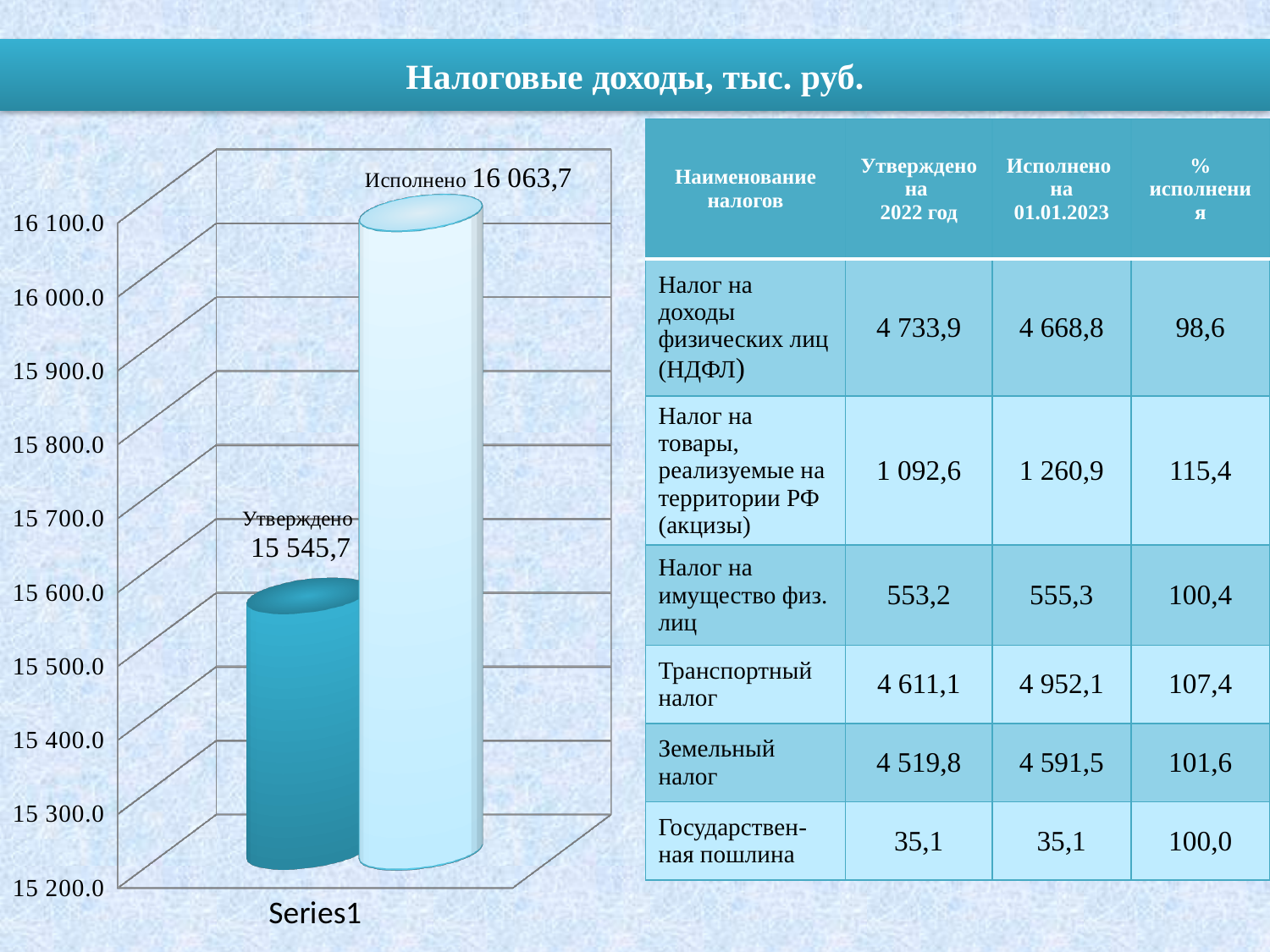
What is the value of the Исполнено bar? 16 063,7 What is the difference between the Исполнено and Утверждено values? 518,0 Is the Утверждено value larger or smaller than the Исполнено value? smaller What is the value of the Утверждено bar? 15 545,7 Is the value for Утверждено greater or less than 15 600.0? less Which bar is higher, Утверждено or Исполнено? Исполнено How many bars are plotted on the chart? 2 Is the value for Исполнено greater or less than 16 000.0? greater Which bar is the lowest on the chart? Утверждено What is the lowest value shown on the vertical axis of the chart? 15 200.0 What is the title of the slide above the chart? Налоговые доходы, тыс. руб. What kind of chart is shown on the slide? bar chart